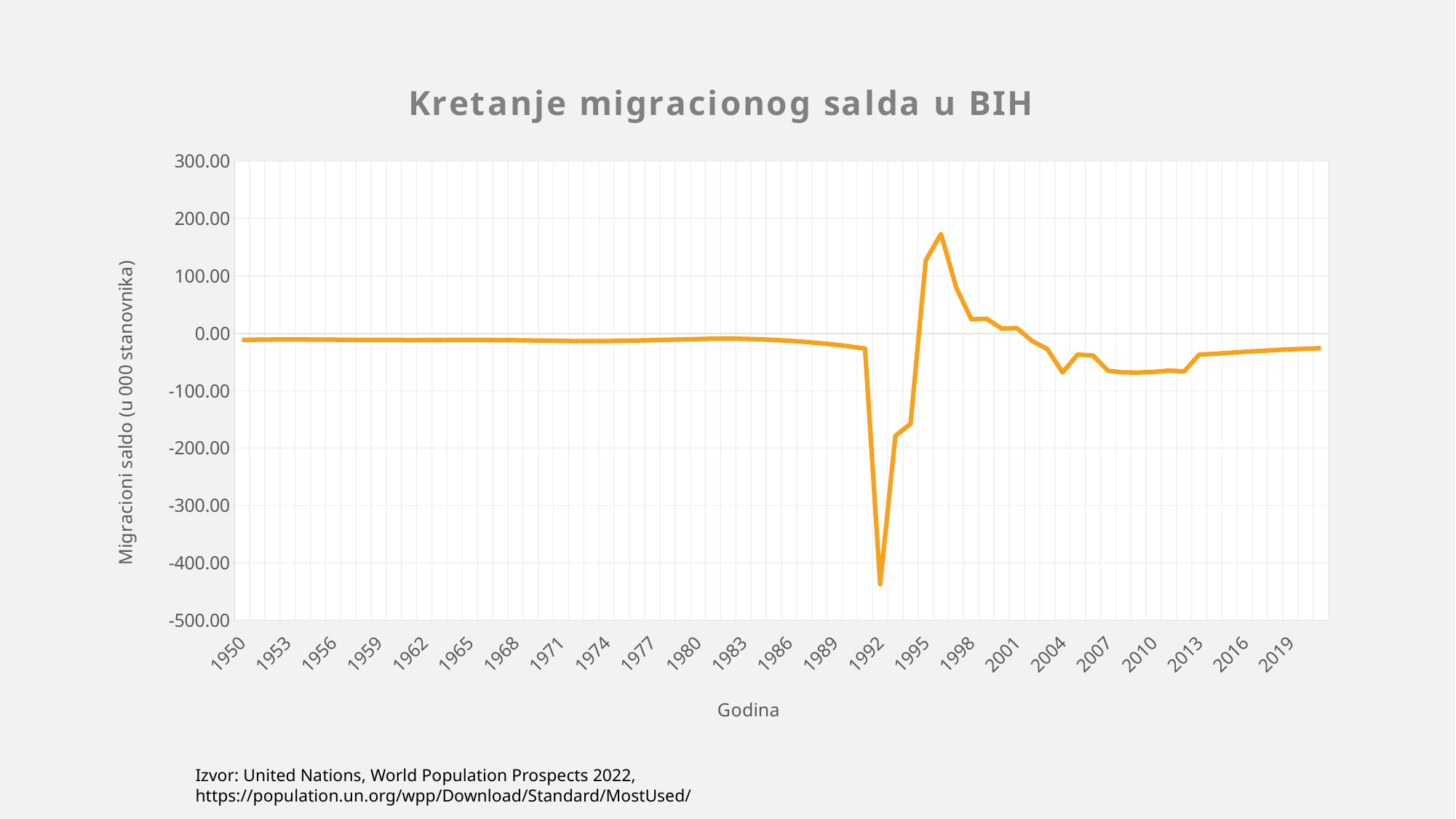
Which year has the larger value, 1950 or 1992? 1950 Is the value for 1995 greater or less than 0? greater In which year does the migration balance reach its lowest value? 1992 Is the value for 1992 greater or less than -400? less What is the label of the vertical axis? Migracioni saldo (u 000 stanovnika) Does the migration balance rise or fall between 2007 and 2019? rise Is the value for 2016 greater or less than 0? less What kind of chart is shown on the slide? line chart Which year has the larger value, 1992 or 1995? 1995 What is the title of the chart? Kretanje migracionog salda u BIH